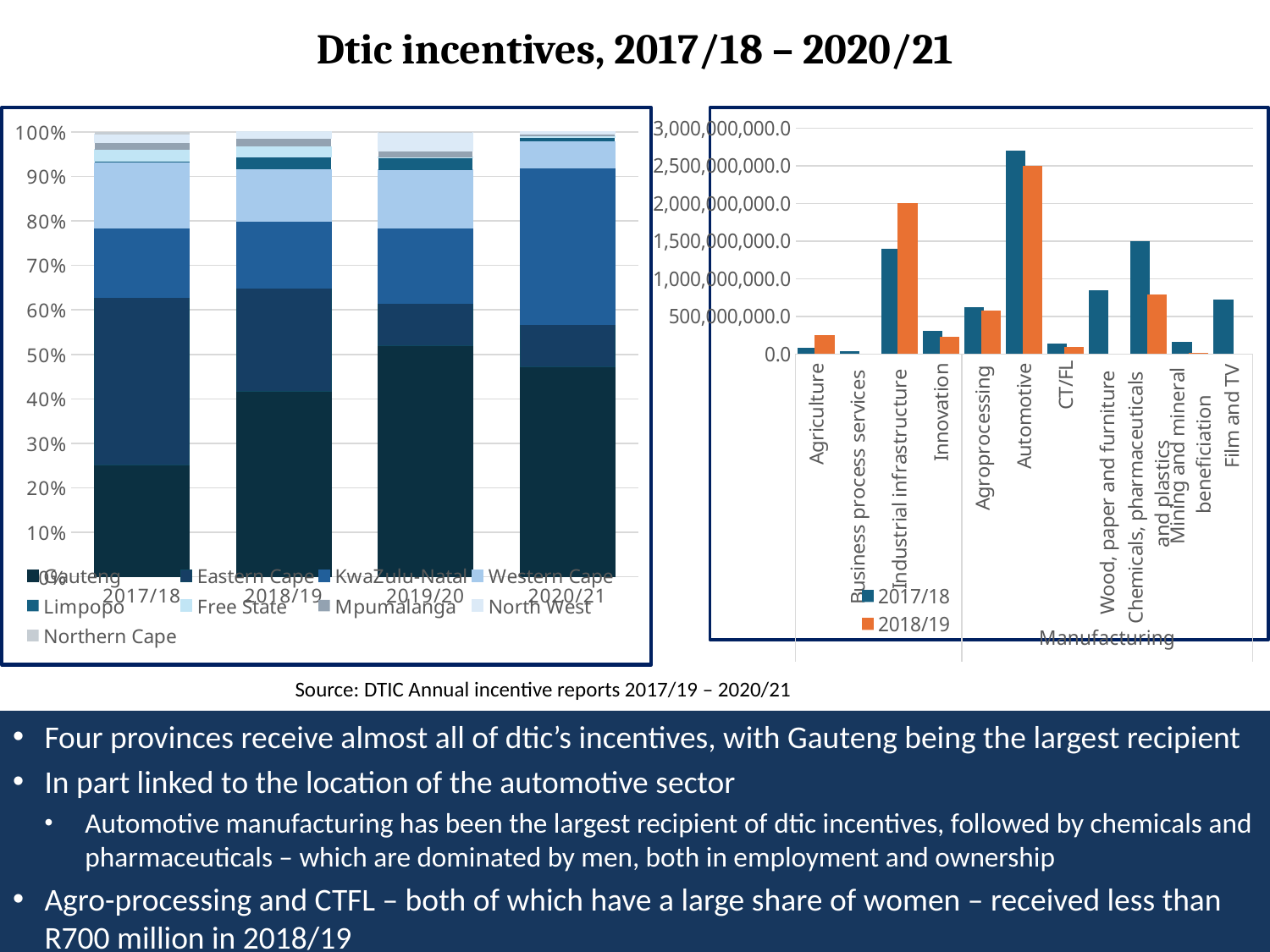
In the chart on the right, which sector has the highest bar? Automotive What kind of chart is the chart on the left of the slide? stacked bar chart In the chart on the left, how many provinces does the legend list? 9 In the chart on the right, for Industrial infrastructure, which series is larger: 2017/18 or 2018/19? 2018/19 In the chart on the right, is the 2018/19 value for Industrial infrastructure greater or less than 1,500,000,000.0? greater In the chart on the right, how many series does the legend list? 2 In the chart on the right, is the 2017/18 value for Automotive greater or less than 2,500,000,000.0? greater In the chart on the left, is Gauteng's share in 2017/18 greater or less than 30%? less In the chart on the right, how many sectors are shown on the x axis? 11 What kind of chart is the chart on the right of the slide? bar chart In the chart on the left, how many years are shown on the x axis? 4 In the chart on the right, for Chemicals, pharmaceuticals and plastics, which series is larger: 2017/18 or 2018/19? 2017/18